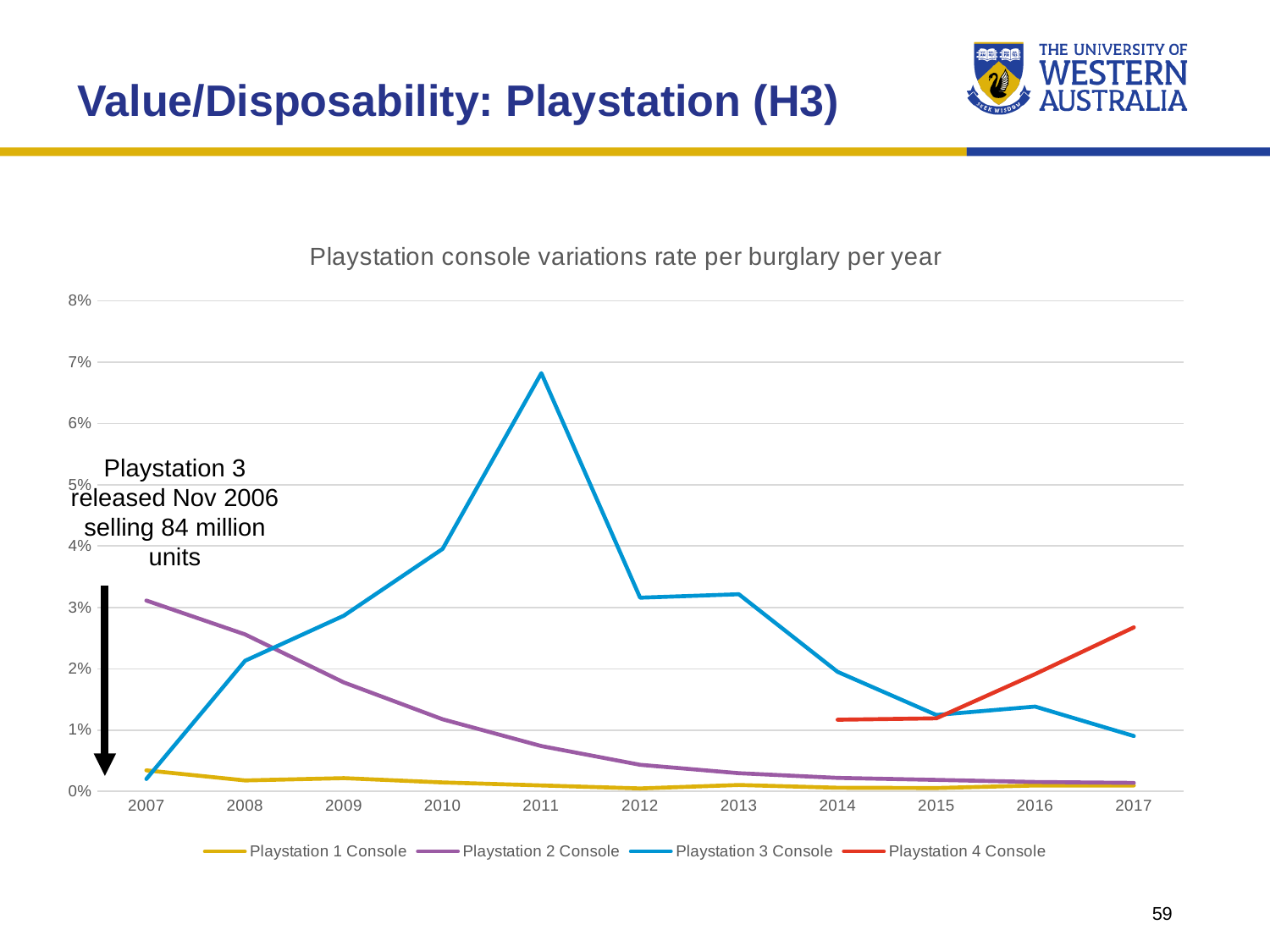
What is the title of the chart? Playstation console variations rate per burglary per year Is the value for Playstation 3 Console in 2011 greater or less than 6%? greater What type of chart is shown on the slide? line chart In 2009, which is larger: Playstation 3 Console or Playstation 2 Console? Playstation 3 Console Which series has the highest value in 2017? Playstation 4 Console How many series does the legend list? 4 In which year does the Playstation 3 Console line reach its highest value? 2011 Is the value for Playstation 4 Console in 2017 greater or less than 2%? greater Does the Playstation 2 Console line rise or fall from 2007 to 2017? fall Which series has the highest value in 2007? Playstation 2 Console Is the value for Playstation 3 Console in 2007 greater or less than 1%? less How many years are shown on the x axis? 11